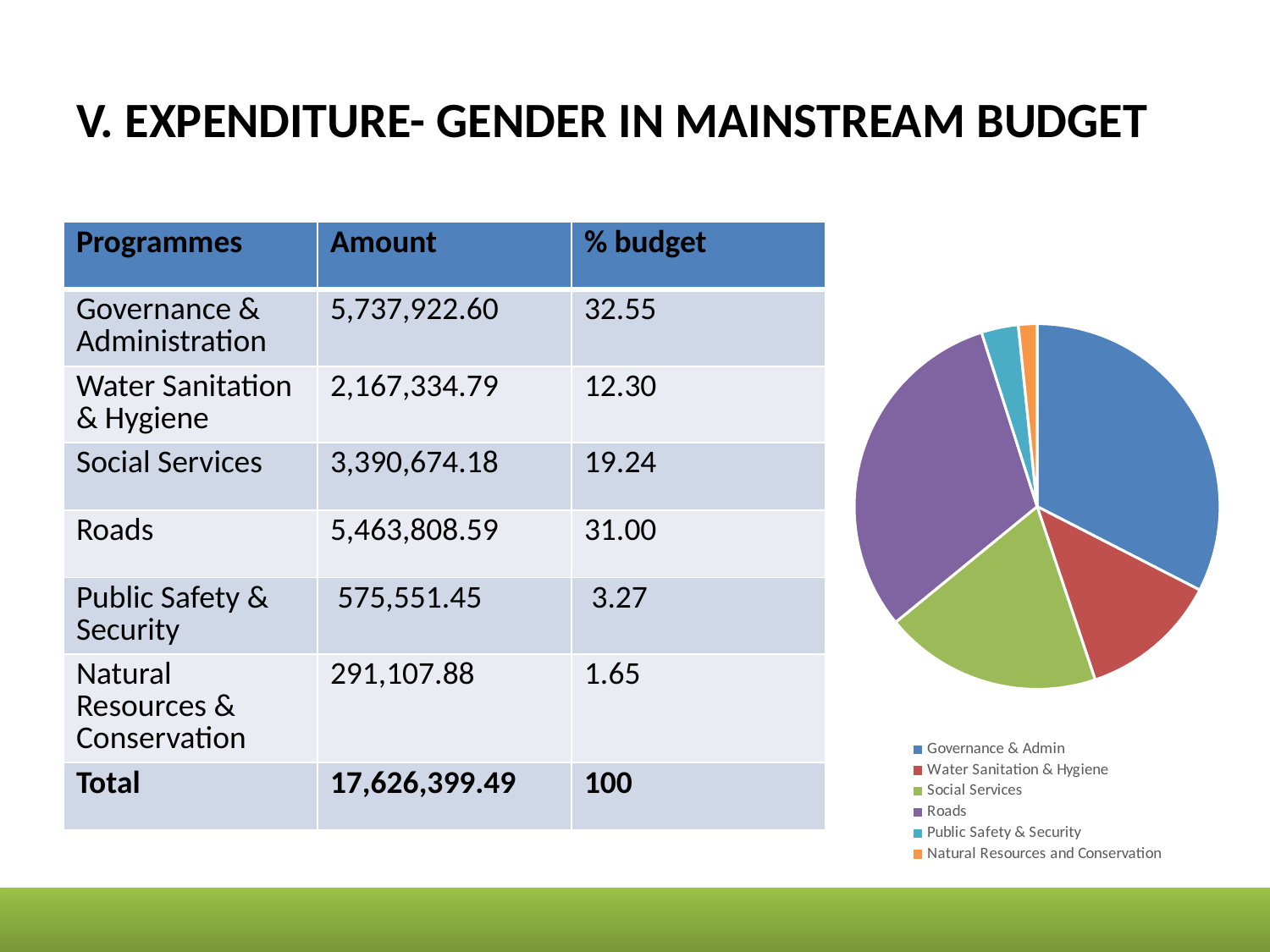
What colour is the Roads slice in the pie chart? Purple What share of the budget does the Roads slice represent, according to the slide? 31.00 In the pie chart, which slice is larger: Social Services or Water Sanitation & Hygiene? Social Services What kind of chart is shown on the slide? Pie chart Which programme has the smallest slice in the pie chart? Natural Resources and Conservation What colour is the Governance & Admin slice in the pie chart? Blue What share of the budget does the Public Safety & Security slice represent, according to the slide? 3.27 How many entries does the pie chart's legend list? 6 What share of the budget does the Social Services slice represent, according to the slide? 19.24 Which programme has the largest slice in the pie chart? Governance & Admin In the pie chart, which slice is larger: Roads or Public Safety & Security? Roads How many slices does the pie chart have? 6